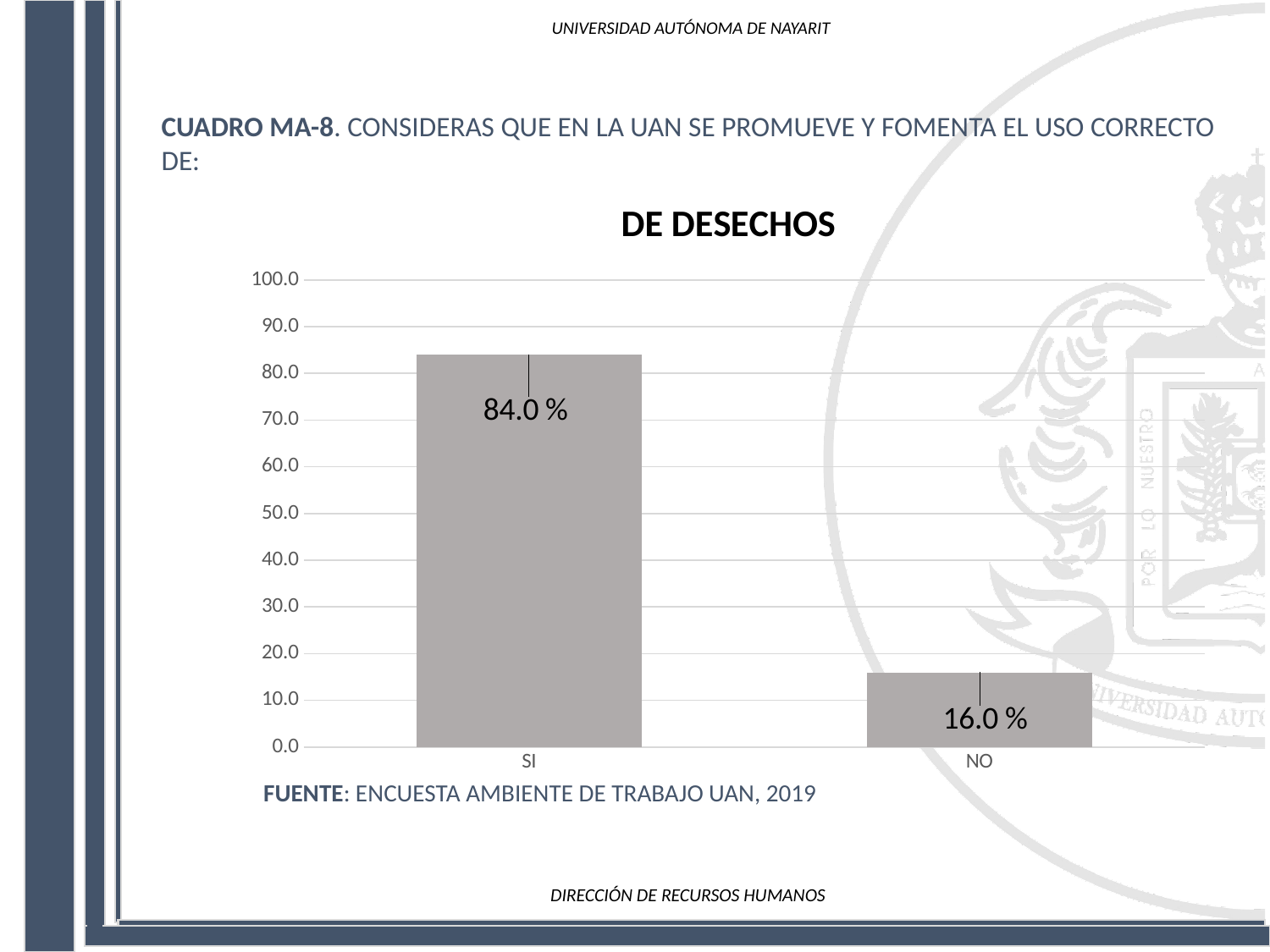
What is the difference between the values for SI and NO? 68.0 % Which category has the lowest value? NO Is the value for SI greater or less than 80.0? greater How many categories are shown on the x axis? 2 What is the value for NO? 16.0 % What is the source cited below the chart? ENCUESTA AMBIENTE DE TRABAJO UAN, 2019 Which is larger, the value for SI or the value for NO? SI Is the value for NO greater or less than 20.0? less What kind of chart is shown? bar chart What is the title of the chart? DE DESECHOS What is the value for SI? 84.0 % Which category has the highest value? SI